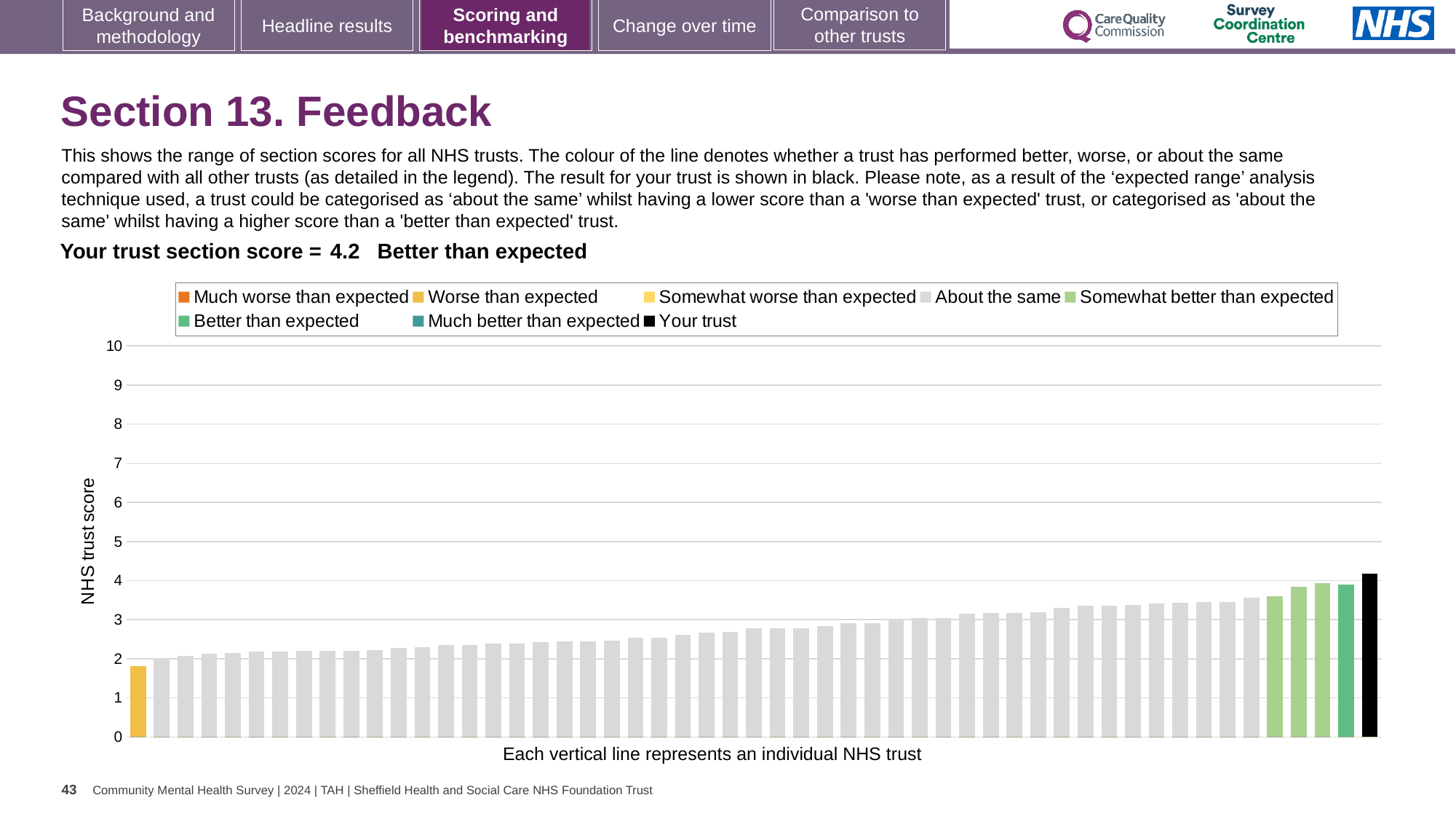
Do the bar values rise or fall from left to right along the x axis? rise What colour is the bar representing your trust? Black Is the value for the lowest bar (the leftmost trust) greater or less than 2? less Which bar in the chart is the highest? Your trust (the black bar) What is the highest value shown on the y axis? 10 How many entries does the chart legend list? 8 What is the section score for your trust shown on the slide? 4.2 Is the value for the tallest bar greater or less than 5? less Is the value for your trust greater or less than 4? greater What kind of chart is shown on the slide? Bar chart Which performance category is your trust's section score given as? Better than expected What is the label on the y axis of the chart? NHS trust score